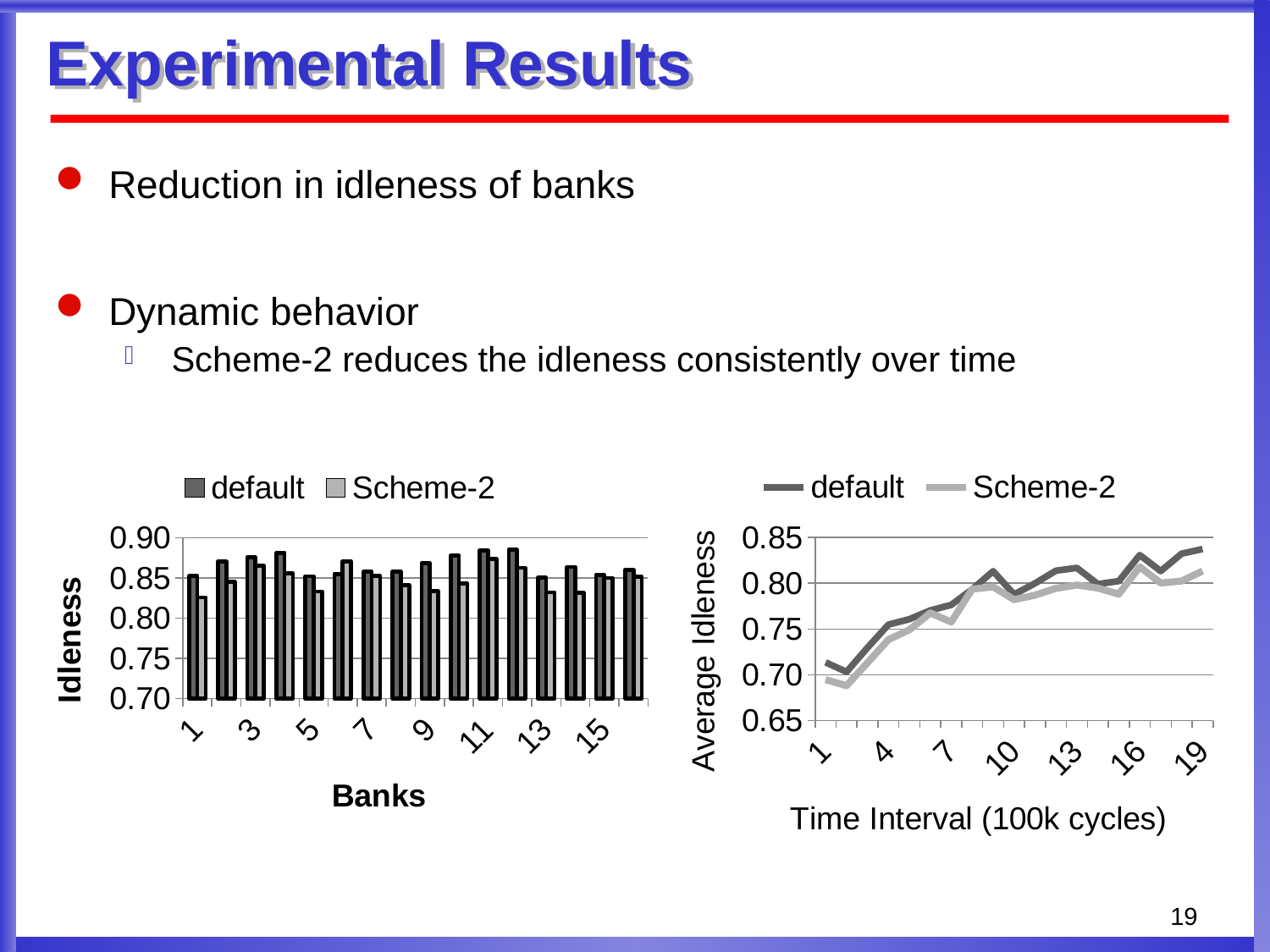
In the right line chart, do the default values generally rise or fall as the time interval increases? rise In the left bar chart, which series has the larger value for bank 1, default or Scheme-2? default In the right line chart, how many time intervals are plotted along the x axis? 19 In the right line chart, which series has the larger value at time interval 1, default or Scheme-2? default In the left bar chart, how many series does the legend list? 2 In the right line chart, what are the two series named in the legend? default and Scheme-2 In the left bar chart, is the default value for bank 1 greater or less than 0.80? greater What is the y-axis label of the right line chart? Average Idleness What kind of chart is the left chart titled with the x-axis 'Banks'? bar chart What kind of chart is the right chart with the x-axis 'Time Interval (100k cycles)'? line chart In the right line chart, is the default value at time interval 19 greater or less than 0.80? greater